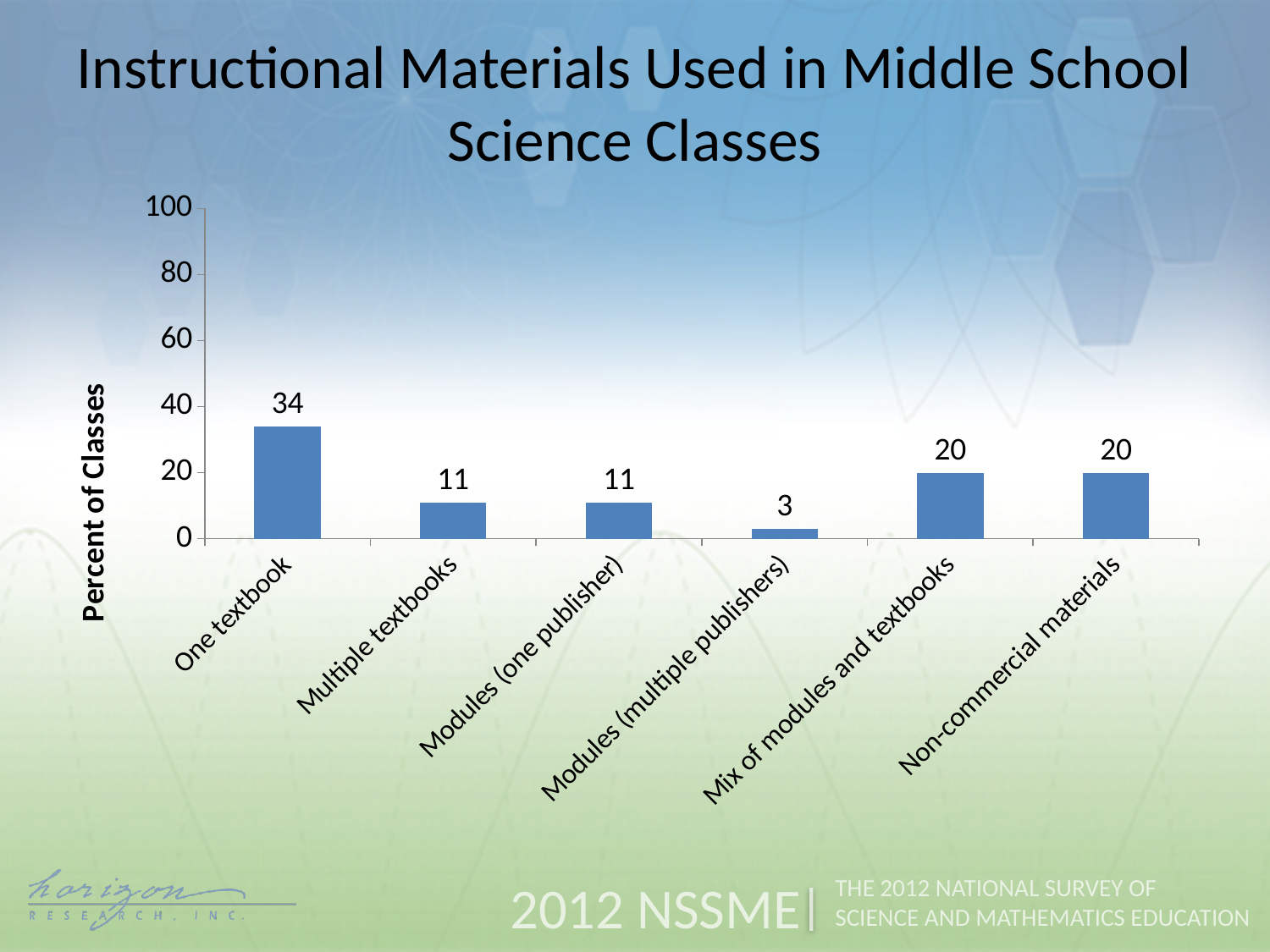
How many categories are shown on the x axis? 6 Which is larger, the value for Multiple textbooks or the value for Mix of modules and textbooks? Mix of modules and textbooks What is the value for Mix of modules and textbooks? 20 Is the value for One textbook greater or less than 40? less What is the difference between the values for One textbook and Non-commercial materials? 14 What is the label of the vertical axis? Percent of Classes What percent of classes use one textbook? 34 Which category has the highest percent of classes? One textbook What is the difference between the values for Multiple textbooks and Modules (multiple publishers)? 8 What is the value for Modules (multiple publishers)? 3 What kind of chart is shown on the slide? bar chart Which category has the lowest percent of classes? Modules (multiple publishers)